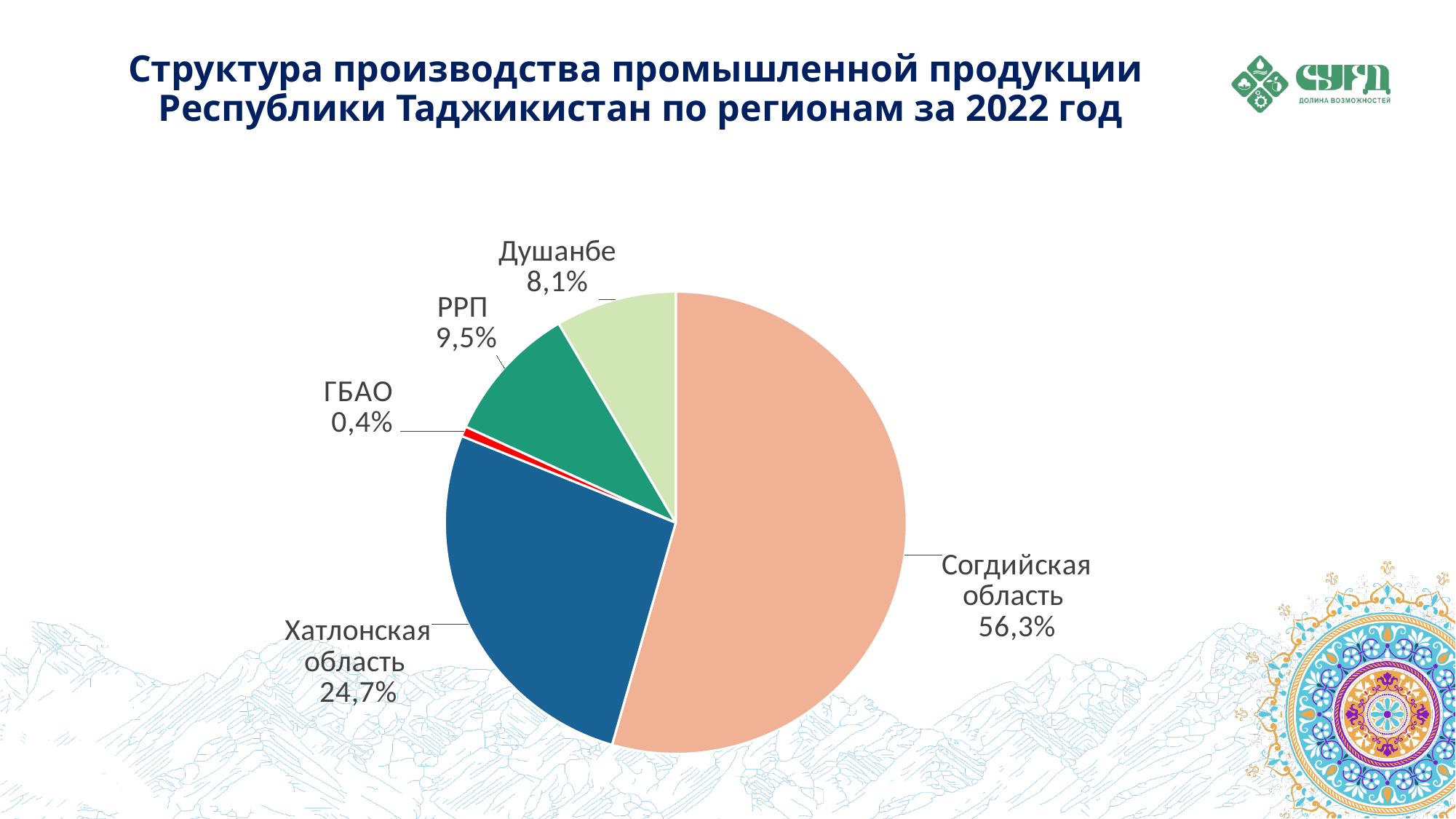
How many regions are shown in the pie chart? 5 What is the value for РРП? 9,5% What colour is the slice for Хатлонская область? Dark blue What percentage is shown for Душанбе? 8,1% What share of industrial production does Согдийская область account for? 56,3% What share is shown for ГБАО? 0,4% Which region has the smallest share? ГБАО Which has a larger share, РРП or Душанбе? РРП What is the value shown for Хатлонская область? 24,7% What type of chart is shown on the slide? Pie chart What is the difference in percentage points between Согдийская область and Хатлонская область? 31,6 Which region has the largest share of industrial production? Согдийская область